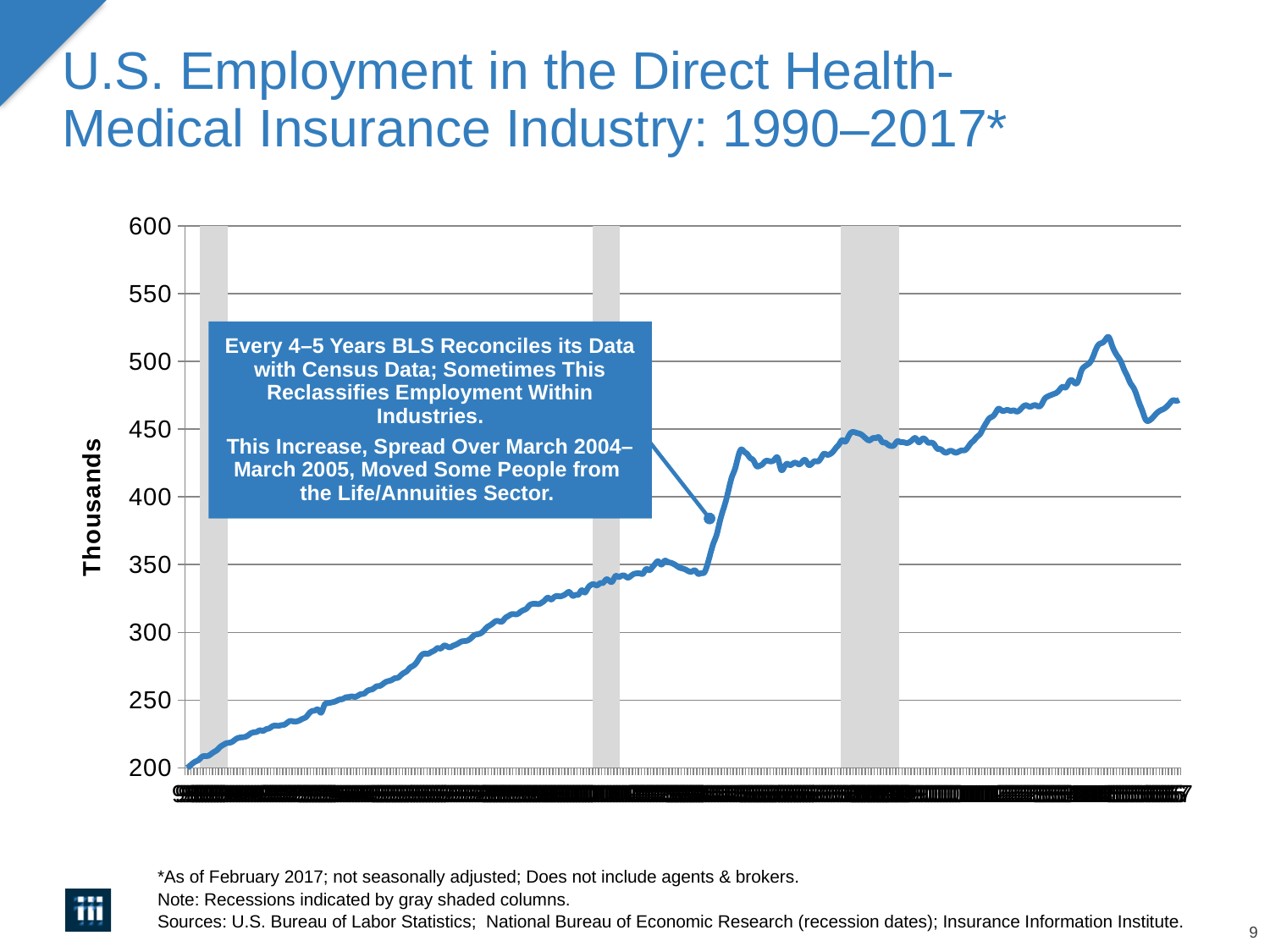
What is the highest value shown on the vertical axis? 600 Overall, do the values rise or fall from the left of the chart to the right? rise Is the highest point reached by the line greater or less than 500? greater What kind of chart is shown on the slide? line chart What is the label on the vertical axis? Thousands Is the value at the end of the series (right end of the line) greater or less than 450? greater How many gray shaded recession columns are shown on the chart? 3 Is the value at the point marked by the callout arrow (just before the sharp jump) greater or less than 400? less